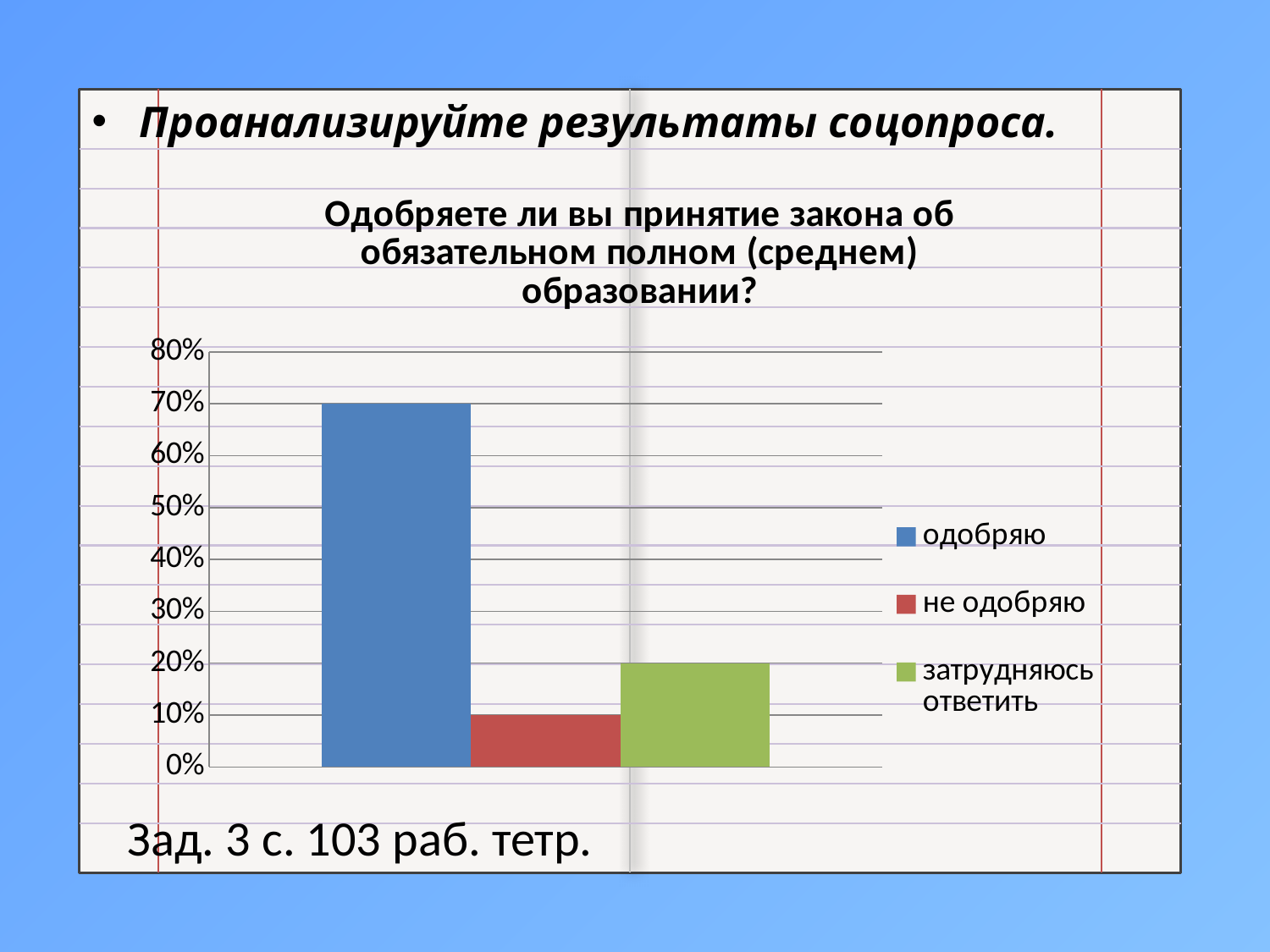
What kind of chart is shown on the slide? bar chart How many series does the legend list? 3 What is the value for "затрудняюсь ответить"? 20% Is the value for "одобряю" greater or less than 50%? greater Which is larger, the value for "затрудняюсь ответить" or the value for "не одобряю"? затрудняюсь ответить What is the value for "не одобряю"? 10% Which response has the highest value? одобряю What is the value for "одобряю"? 70% What colour is the bar for "не одобряю"? red What is the difference between the values for "одобряю" and "не одобряю"? 60% What is the difference between the values for "затрудняюсь ответить" and "не одобряю"? 10% Which response has the lowest value? не одобряю